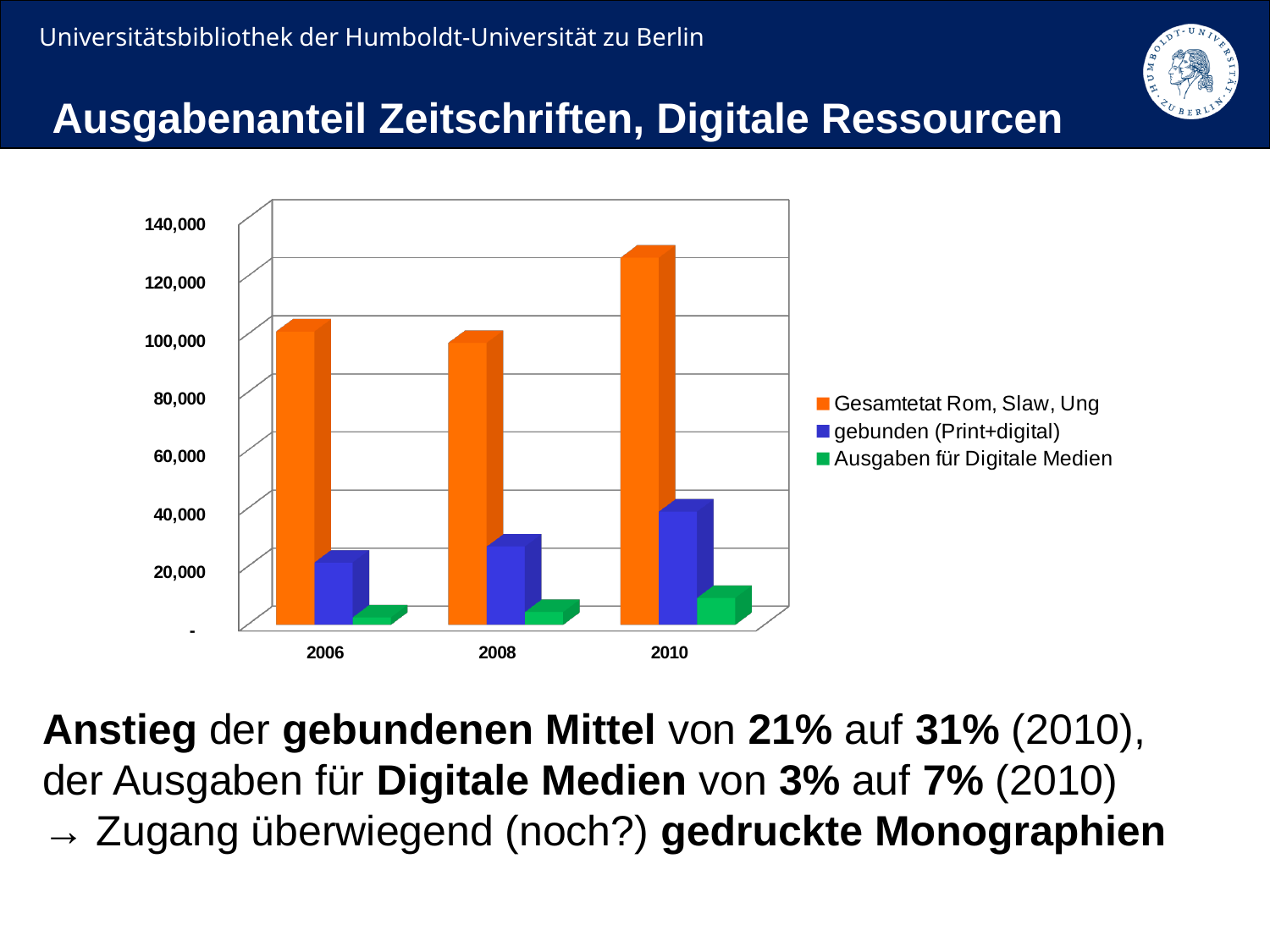
In which year is the value for Gesamtetat Rom, Slaw, Ung highest? 2010 Which colour represents Gesamtetat Rom, Slaw, Ung in the legend? orange How many years are shown on the x axis? 3 Is the value for Ausgaben für Digitale Medien in 2010 greater or less than 20,000? less How many series does the legend list? 3 In which year is the value for gebunden (Print+digital) highest? 2010 In which year is the value for Ausgaben für Digitale Medien lowest? 2006 Which is larger: gebunden (Print+digital) in 2010 or gebunden (Print+digital) in 2006? 2010 Is the value for gebunden (Print+digital) in 2006 greater or less than 40,000? less What kind of chart is shown on the slide? bar chart Do the values for gebunden (Print+digital) rise or fall from 2006 to 2010? rise Is the value for Gesamtetat Rom, Slaw, Ung in 2010 greater or less than 120,000? greater